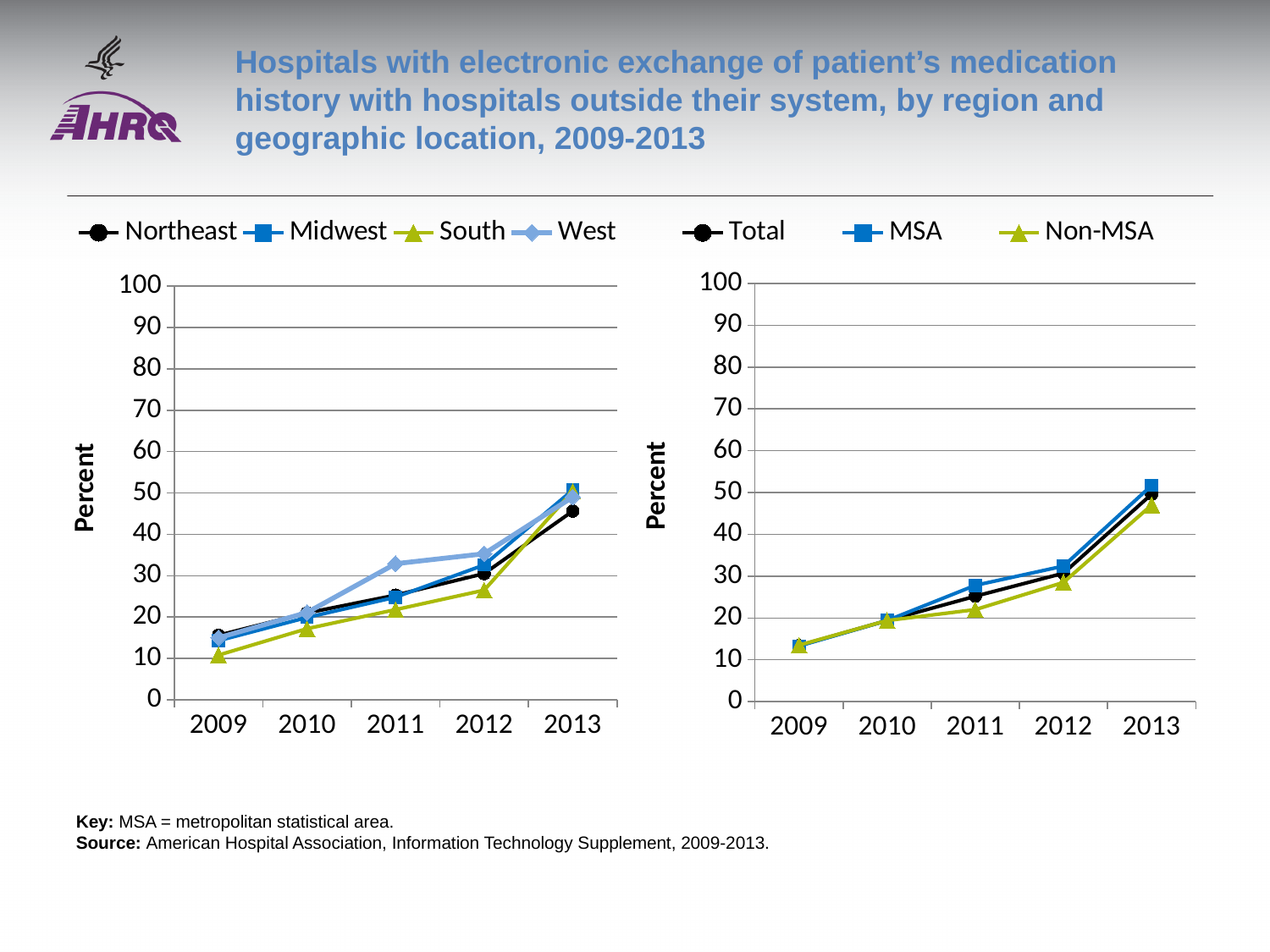
On the left chart (by region), do the values for South rise or fall from 2009 to 2013? Rise On the left chart (by region), how many series does the legend list? 4 On the left chart (by region), which region has the lowest value in 2009? South On the left chart (by region), which region has the highest value in 2011? West On the right chart (by geographic location), is the value for Non-MSA in 2013 greater or less than 40? greater On the left chart (by region), is the value for West in 2011 greater or less than 30? greater On the right chart (by geographic location), which is larger in 2011, MSA or Non-MSA? MSA On the left chart (by region), is the value for South in 2009 greater or less than 20? less On the right chart (by geographic location), which series has the lowest value in 2013? Non-MSA On the right chart (by geographic location), how many years are shown on the x axis? 5 What kind of chart is the left chart (by region)? Line chart On the right chart (by geographic location), how many series does the legend list? 3